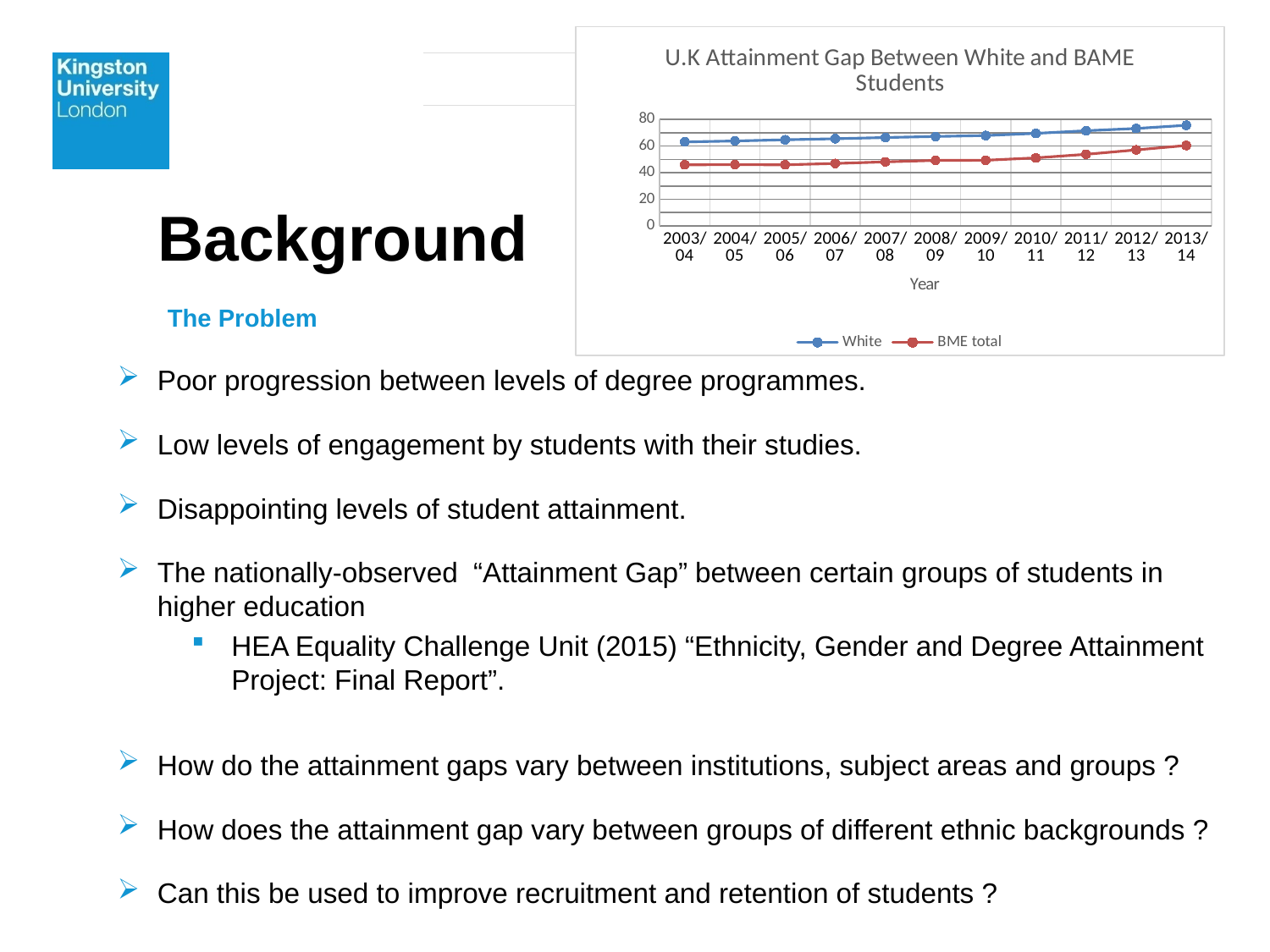
In 2013/14, which series has the higher value, White or BME total? White Is the value for BME total in 2003/04 greater or less than 40? greater How many years are plotted along the x axis of the chart? 11 Do the values for BME total rise or fall from 2003/04 to 2013/14? rise Is the value for BME total in 2003/04 greater or less than 60? less Is the value for White in 2003/04 greater or less than 60? greater What is the title of the chart? U.K Attainment Gap Between White and BAME Students What kind of chart is shown on the slide? line chart What is the label of the x axis? Year In which year does the White series reach its highest value? 2013/14 How many series does the chart's legend list? 2